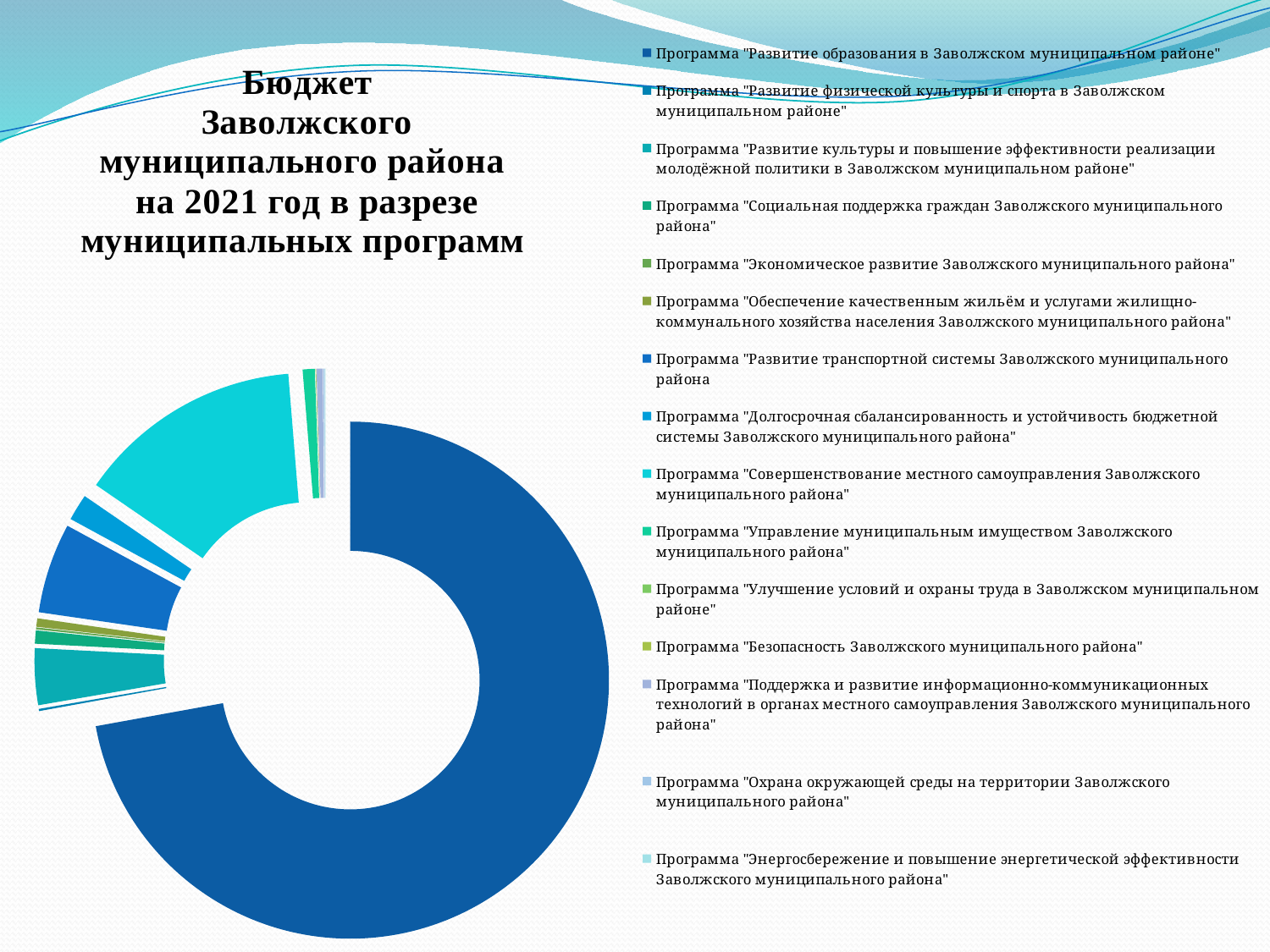
Which is larger: the slice for "Развитие образования в Заволжском муниципальном районе" or the slice for "Безопасность Заволжского муниципального района"? Развитие образования в Заволжском муниципальном районе Which program has the largest share of the 2021 budget in the chart? Программа "Развитие образования в Заволжском муниципальном районе" How many municipal programs are listed in the chart legend? 15 Which legend entry is listed last in the chart legend? Программа "Энергосбережение и повышение энергетической эффективности Заволжского муниципального района" What kind of chart is shown on the slide? Doughnut (pie) chart What is the title of the chart on the slide? Бюджет Заволжского муниципального района на 2021 год в разрезе муниципальных программ Which legend entry is listed first in the chart legend? Программа "Развитие образования в Заволжском муниципальном районе"